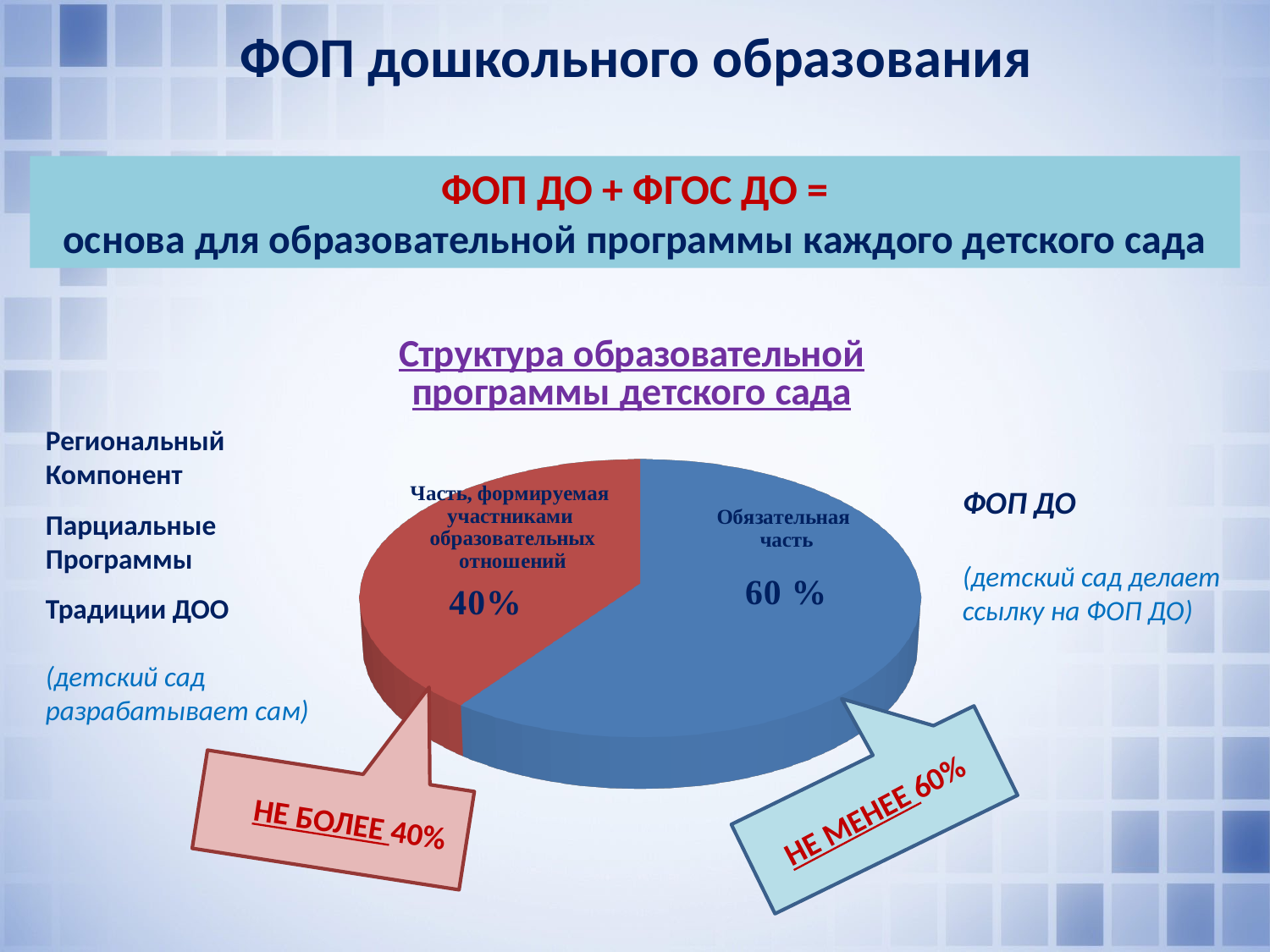
What share of the pie is labelled "Часть, формируемая участниками образовательных отношений"? 40% What colour is the "Обязательная часть" slice of the pie? blue Which is larger: the share for "Обязательная часть" or the share for "Часть, формируемая участниками образовательных отношений"? Обязательная часть What kind of chart is shown on the slide? pie chart What is the title of the chart? Структура образовательной программы детского сада Which slice of the pie is the largest? Обязательная часть Which slice of the pie is the smallest? Часть, формируемая участниками образовательных отношений Is the share for "Часть, формируемая участниками образовательных отношений" greater or less than 50%? less What is the difference in percentage points between the "Обязательная часть" slice and the "Часть, формируемая участниками образовательных отношений" slice? 20 What share of the pie is labelled "Обязательная часть"? 60 % How many slices does the pie chart have? 2